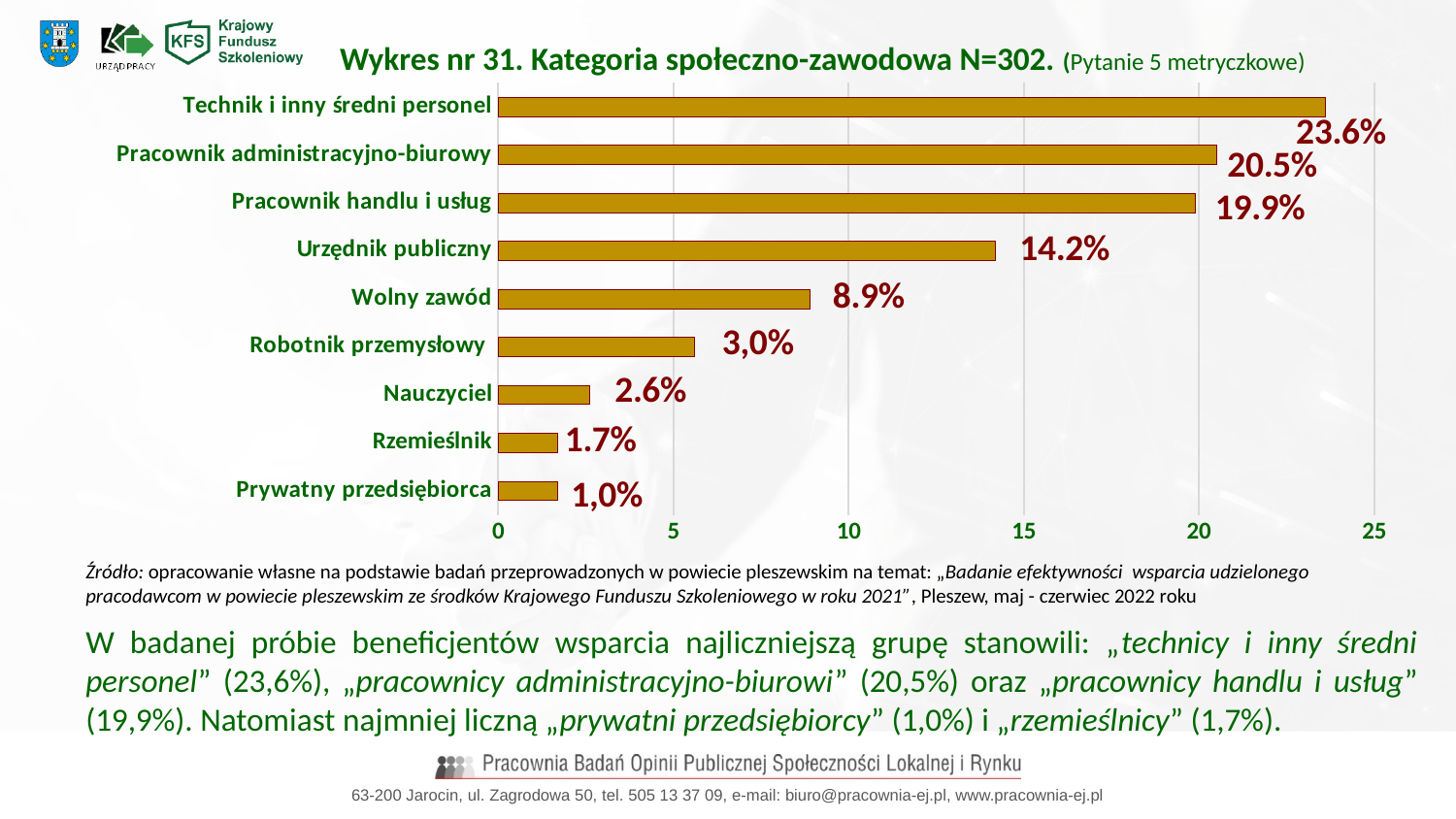
How many categories are shown in the chart? 9 Which category has the lowest value? Prywatny przedsiębiorca Is the value for Pracownik handlu i usług greater or less than 15? greater What is the title of the chart? Wykres nr 31. Kategoria społeczno-zawodowa N=302. (Pytanie 5 metryczkowe) What is the value for Urzędnik publiczny? 14.2% What is the value for Rzemieślnik? 1.7% What is the value for Technik i inny średni personel? 23.6% What is the difference between the values for Technik i inny średni personel and Pracownik administracyjno-biurowy? 3.1 percentage points Which is larger, the value for Wolny zawód or the value for Nauczyciel? Wolny zawód Which category has the highest value? Technik i inny średni personel What kind of chart is shown on the slide? Bar chart What is the value for Robotnik przemysłowy? 3,0%